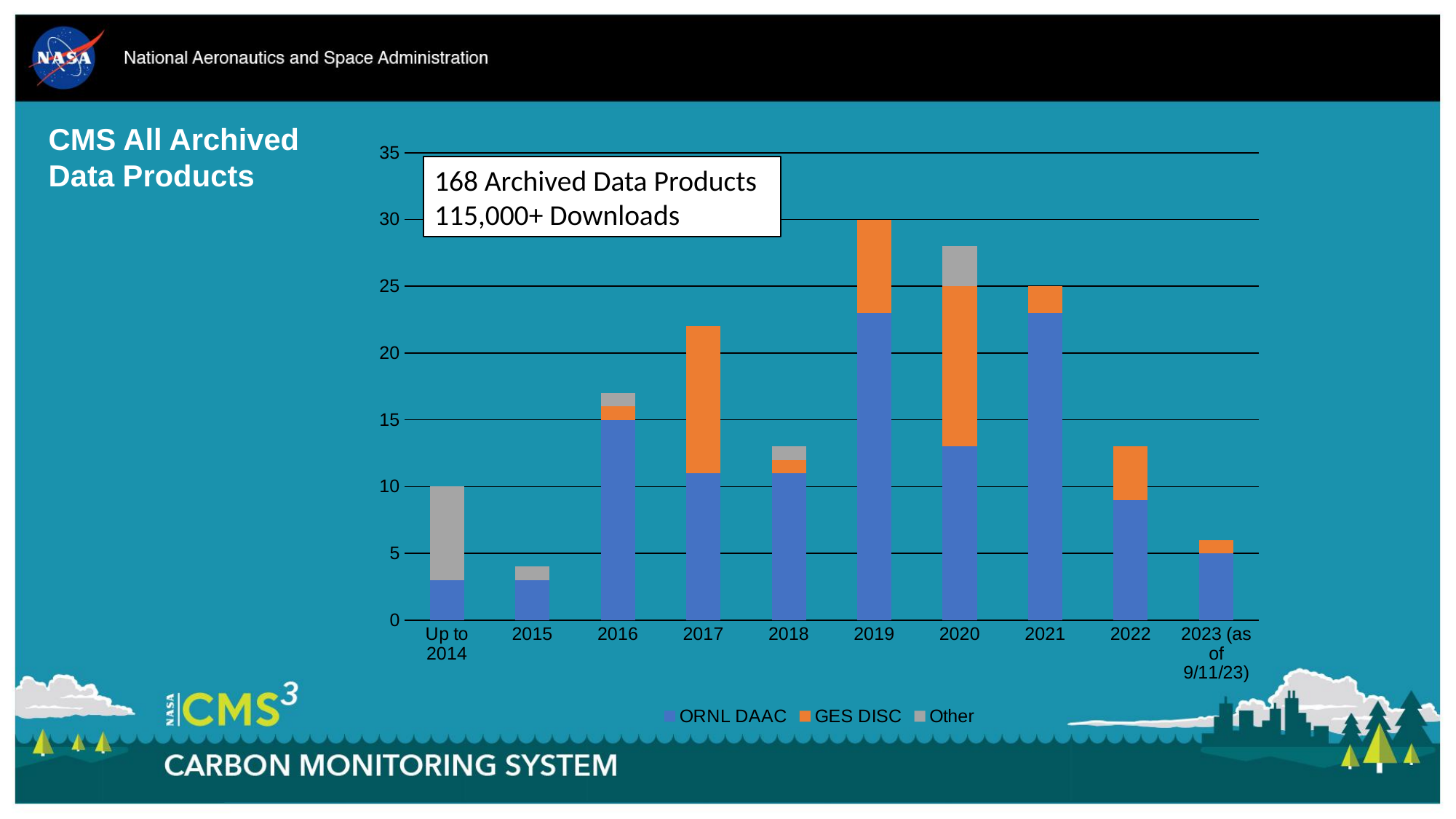
Which year has the shortest stacked bar? 2015 What is the total height of the stacked bar for 2019? 30 What kind of chart is shown on the slide? Stacked bar chart Which year has the tallest stacked bar? 2019 How many series does the legend list? 3 Which year has a larger total, 2020 or 2022? 2020 What is the ORNL DAAC value for 2016? 15 Is the total for 2017 greater or less than 20? greater What is the total height of the stacked bar for 2021? 25 How many year categories are shown on the x axis? 10 What is the total height of the stacked bar for 'Up to 2014'? 10 Which colour represents GES DISC in the legend? Orange